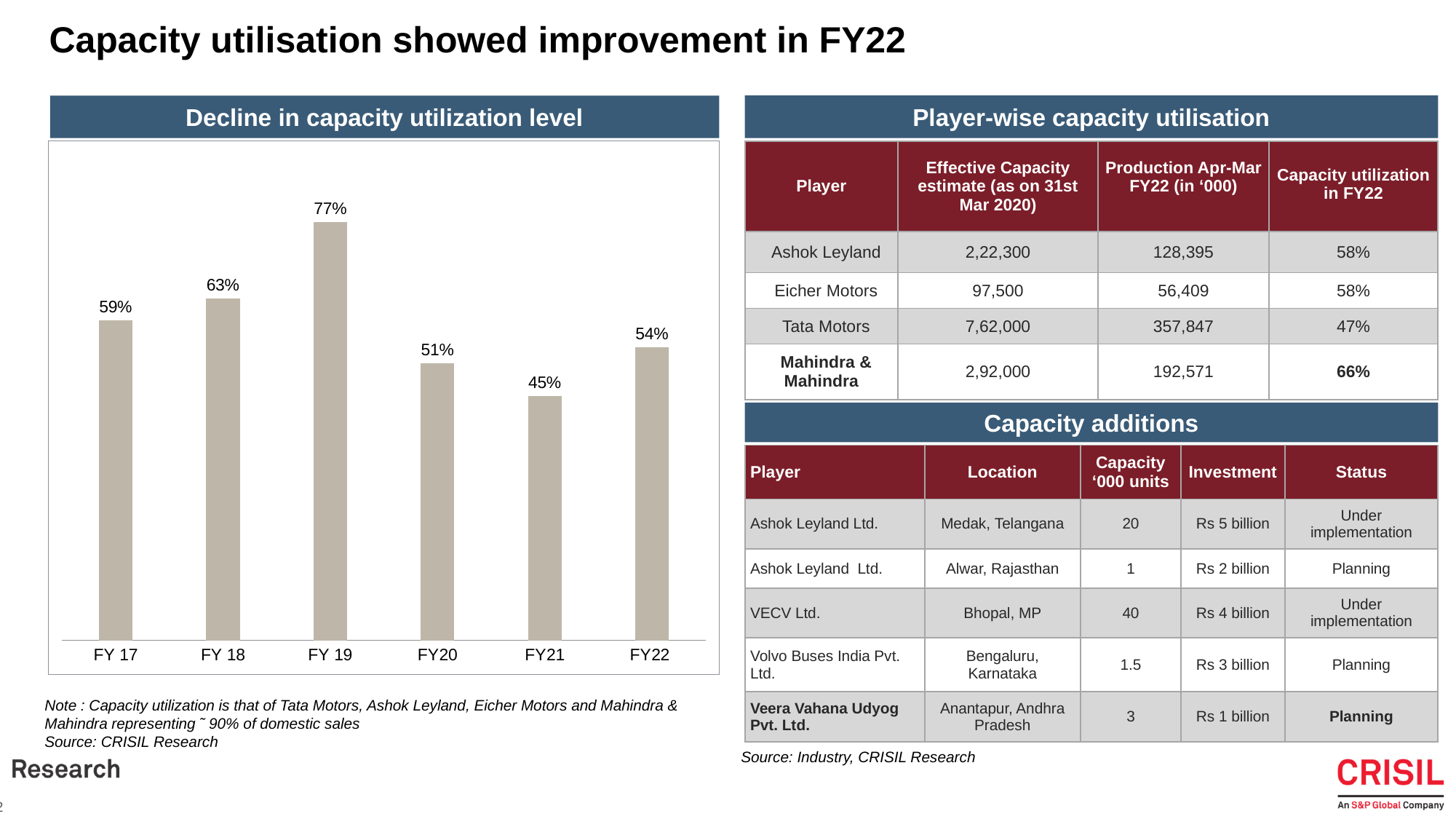
Which fiscal year has the highest capacity utilization level in the chart? FY 19 Which fiscal year has the lowest capacity utilization level in the chart? FY21 Does capacity utilization rise or fall from FY 19 to FY21? Fall What type of chart is used to show the decline in capacity utilization level? Bar chart By how many percentage points did capacity utilization rise from FY21 to FY22? 9 percentage points Which is larger, the capacity utilization in FY 17 or in FY 18? FY 18 What is the title of the chart on the left of the slide? Decline in capacity utilization level What is the capacity utilization level for FY22? 54% What is the capacity utilization level for FY21? 45% What is the difference in capacity utilization between FY 19 and FY20? 26% What is the capacity utilization level for FY 19? 77% How many fiscal years are shown in the chart? 6